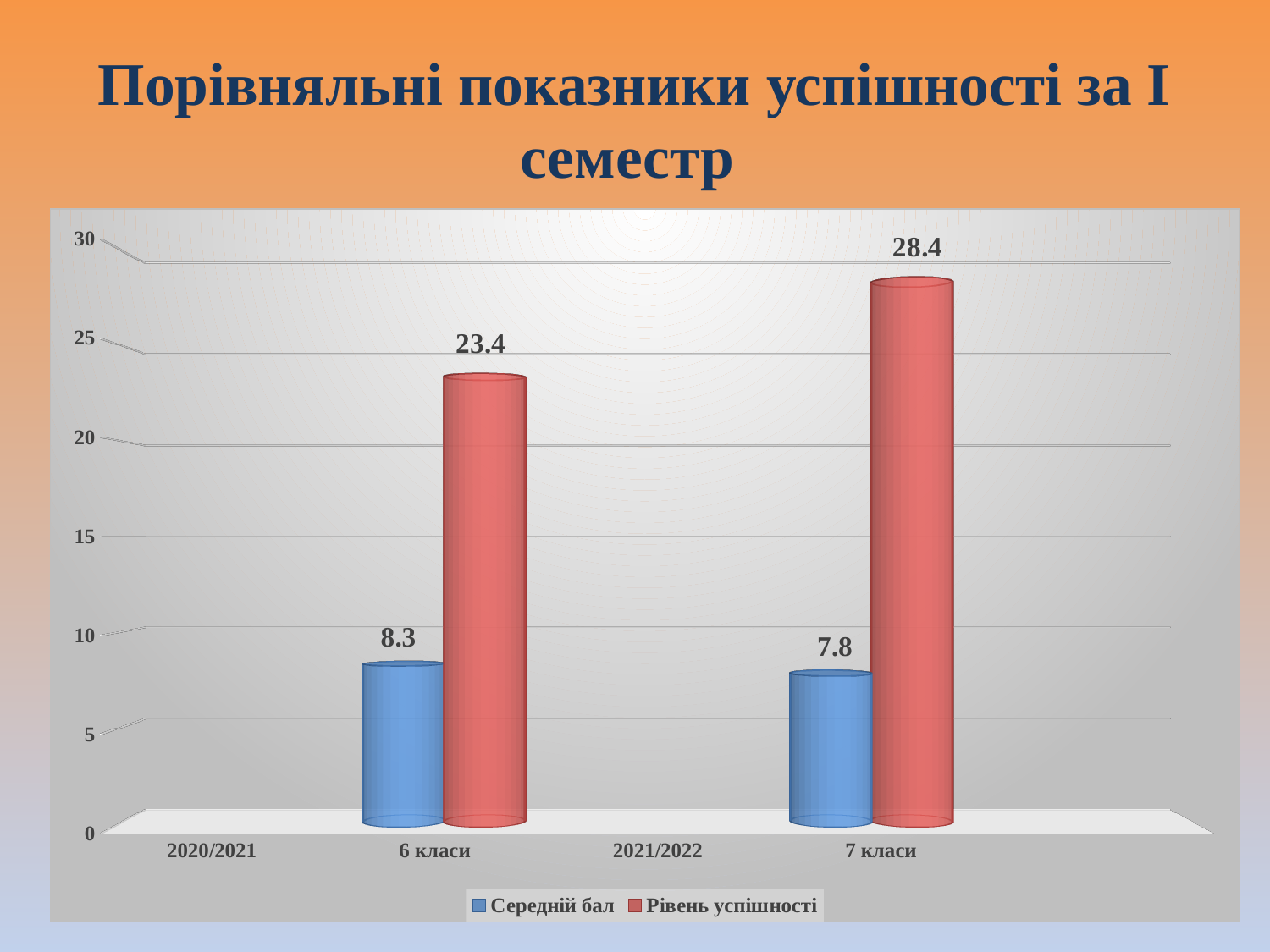
How many series does the legend list? 2 What is the value of Середній бал for 7 класи? 7.8 What is the value of Середній бал for 6 класи? 8.3 Which group has the higher Середній бал, 6 класи or 7 класи? 6 класи Which group has the higher Рівень успішності, 6 класи or 7 класи? 7 класи What is the difference in Середній бал between 6 класи and 7 класи? 0.5 Which bar on the chart has the highest value? Рівень успішності for 7 класи (28.4) What is the value of Рівень успішності for 6 класи? 23.4 What type of chart is shown on the slide? Bar chart What is the difference in Рівень успішності between 7 класи and 6 класи? 5 Which bar on the chart has the lowest value? Середній бал for 7 класи (7.8) What is the value of Рівень успішності for 7 класи? 28.4